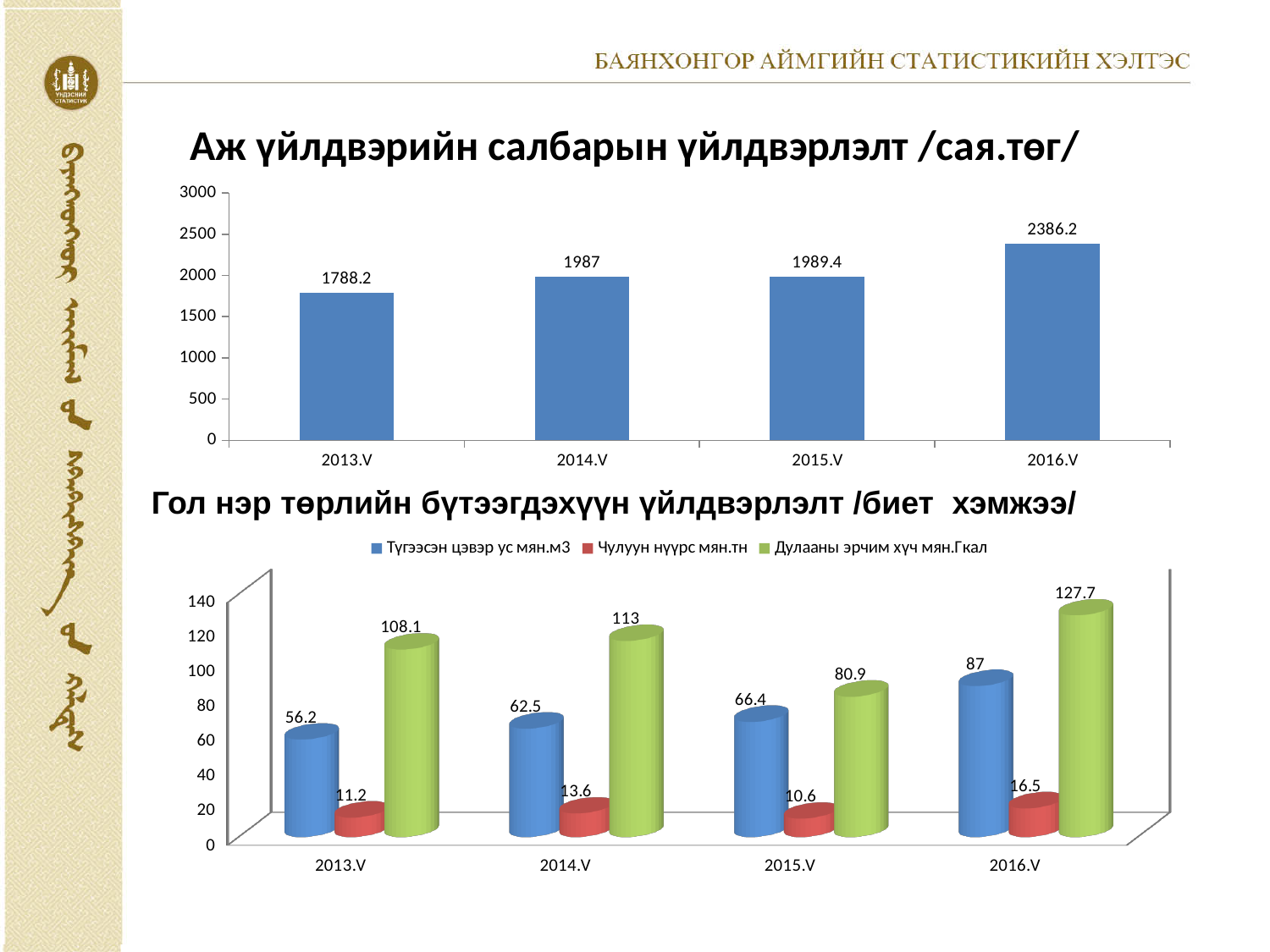
In the top chart (Аж үйлдвэрийн салбарын үйлдвэрлэлт /сая.төг/), what is the difference between the 2016.V and 2013.V values? 598 In the bottom chart (Гол нэр төрлийн бүтээгдэхүүн үйлдвэрлэлт /биет хэмжээ/), what is the value of Чулуун нүүрс мян.тн for 2014.V? 13.6 In the top chart (Аж үйлдвэрийн салбарын үйлдвэрлэлт /сая.төг/), do the values rise or fall from 2013.V to 2016.V? rise In the bottom chart (Гол нэр төрлийн бүтээгдэхүүн үйлдвэрлэлт /биет хэмжээ/), which is larger for 2015.V: Түгээсэн цэвэр ус мян.м3 or Дулааны эрчим хүч мян.Гкал? Дулааны эрчим хүч мян.Гкал In the bottom chart (Гол нэр төрлийн бүтээгдэхүүн үйлдвэрлэлт /биет хэмжээ/), in which year is Түгээсэн цэвэр ус мян.м3 highest? 2016.V In the top chart (Аж үйлдвэрийн салбарын үйлдвэрлэлт /сая.төг/), how many years are shown on the x axis? 4 In the bottom chart (Гол нэр төрлийн бүтээгдэхүүн үйлдвэрлэлт /биет хэмжээ/), how many series does the legend list? 3 In the bottom chart (Гол нэр төрлийн бүтээгдэхүүн үйлдвэрлэлт /биет хэмжээ/), what is the value of Дулааны эрчим хүч мян.Гкал for 2015.V? 80.9 In the top chart (Аж үйлдвэрийн салбарын үйлдвэрлэлт /сая.төг/), what is the value for 2016.V? 2386.2 In the bottom chart (Гол нэр төрлийн бүтээгдэхүүн үйлдвэрлэлт /биет хэмжээ/), what is the difference between Дулааны эрчим хүч мян.Гкал in 2016.V and 2015.V? 46.8 What kind of chart is the top chart (Аж үйлдвэрийн салбарын үйлдвэрлэлт /сая.төг/)? bar chart In the top chart (Аж үйлдвэрийн салбарын үйлдвэрлэлт /сая.төг/), which year has the lowest value? 2013.V